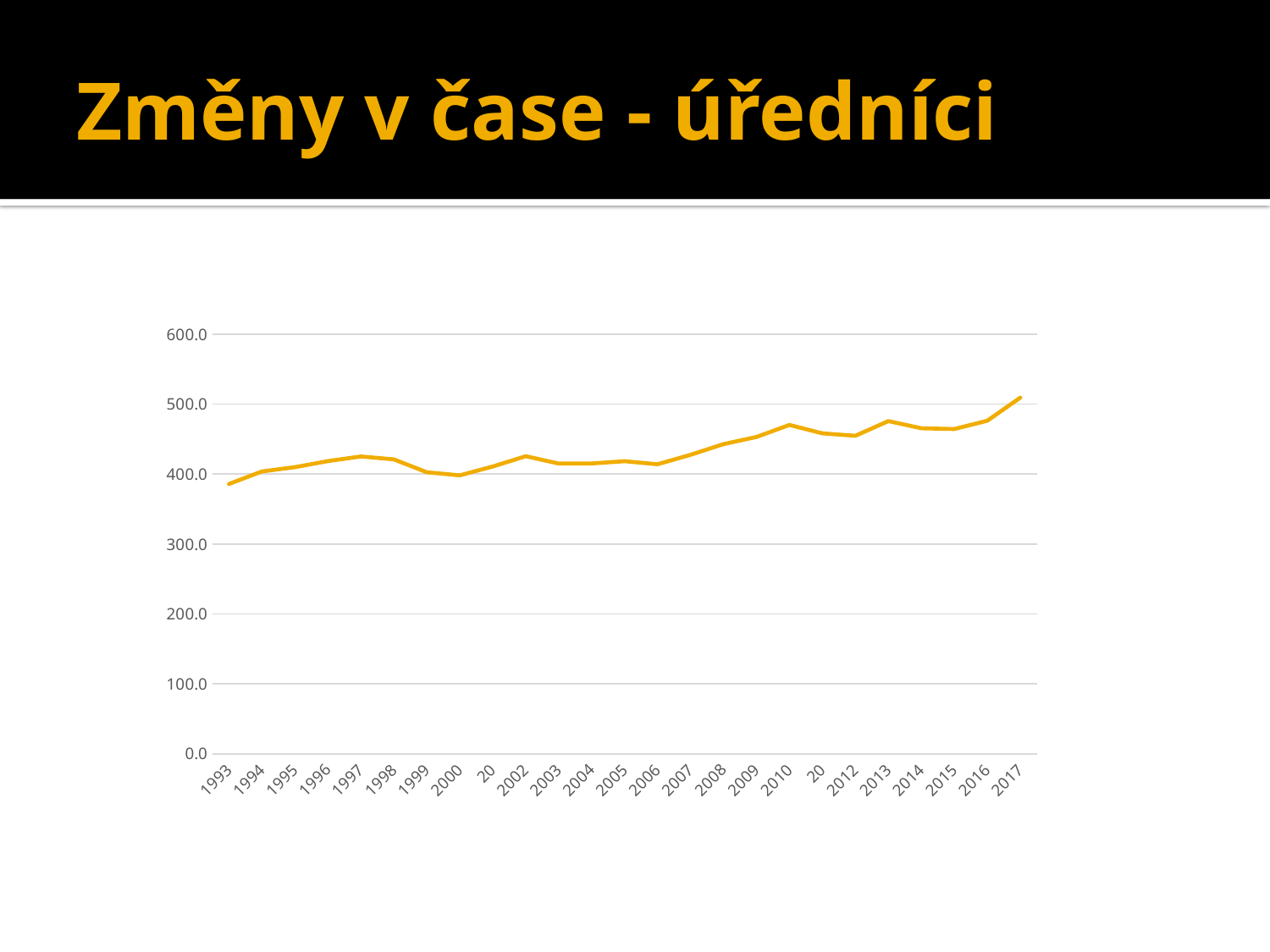
What is the title of the slide containing the chart? Změny v čase - úředníci Which year has the lowest value in the chart? 1993 Overall, do the values rise or fall from 1993 to 2017? rise What kind of chart is shown on the slide? line chart Is the value for 2010 greater or less than 400.0? greater Is the value for 2013 greater or less than 500.0? less Is the value for 1993 greater or less than 400.0? less How many years (data points) are plotted along the x axis? 25 Which year has the larger value, 2010 or 2000? 2010 Which year has the larger value, 2017 or 1993? 2017 What colour is the line in the chart? orange/yellow Which year has the highest value in the chart? 2017